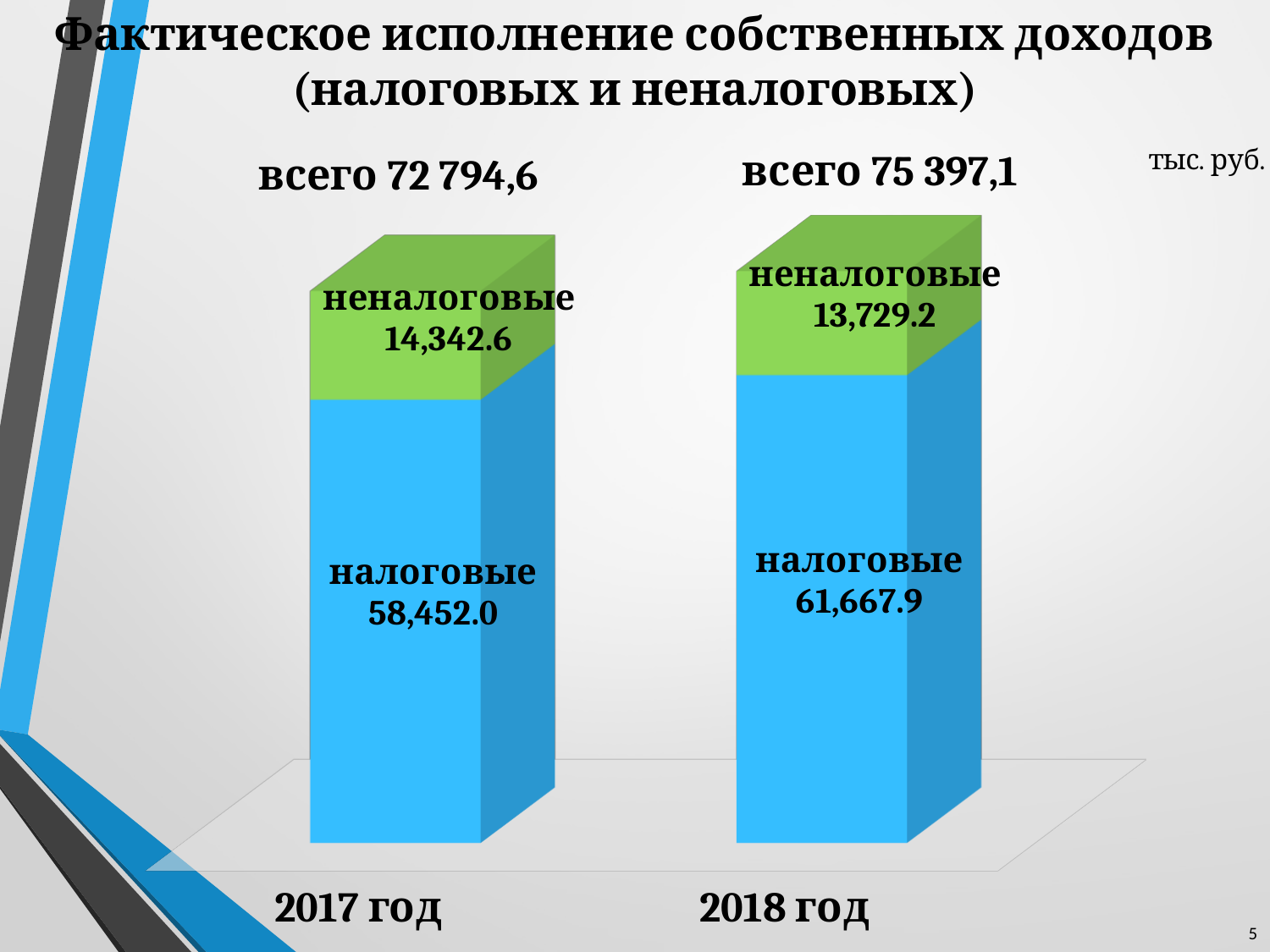
What is the value of неналоговые for 2018 год? 13,729.2 What is the value of налоговые for 2018 год? 61,667.9 What is the value of неналоговые for 2017 год? 14,342.6 What is the total (всего) shown for the 2017 год bar? 72 794,6 What is the total (всего) shown for the 2018 год bar? 75 397,1 What is the difference between the неналоговые values for 2017 год and 2018 год? 613.4 What is the value of налоговые for 2017 год? 58,452.0 What kind of chart is shown on the slide? Stacked bar chart Which year has the higher налоговые value, 2017 год or 2018 год? 2018 год How many years (categories) are shown in the chart? 2 What is the difference between the налоговые values for 2018 год and 2017 год? 3,215.9 Which year has the lower неналоговые value? 2018 год